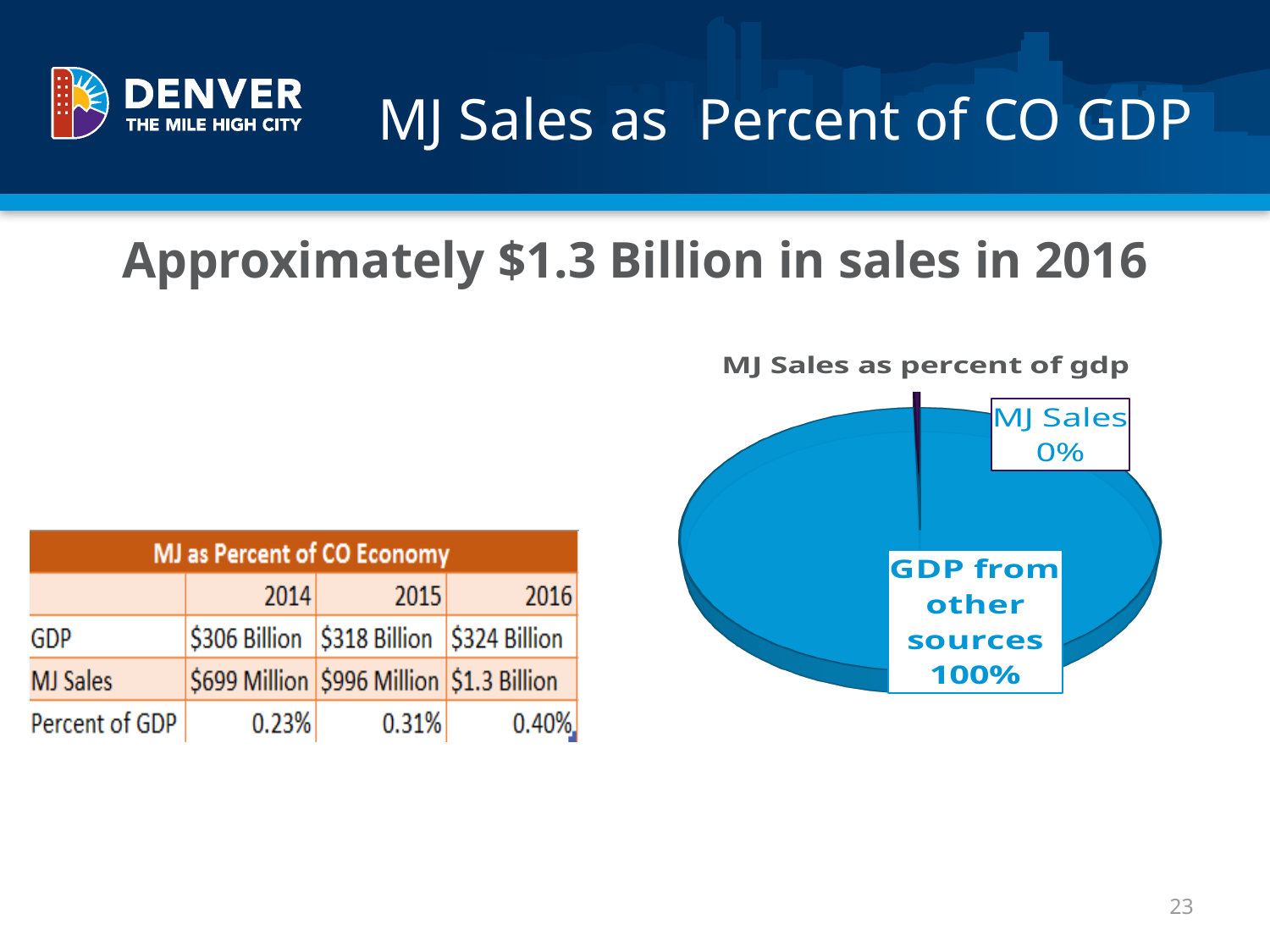
Which slice of the pie chart is the smallest? MJ Sales What are the two slice labels shown on the pie chart? MJ Sales and GDP from other sources What is the title of the pie chart? MJ Sales as percent of gdp What share of the pie chart is labelled for GDP from other sources? 100% In the pie chart, which is larger: MJ Sales or GDP from other sources? GDP from other sources How many slices does the pie chart have? 2 Which slice of the pie chart is the largest? GDP from other sources What share of the pie chart is labelled for MJ Sales? 0% What kind of chart is shown on the slide? pie chart